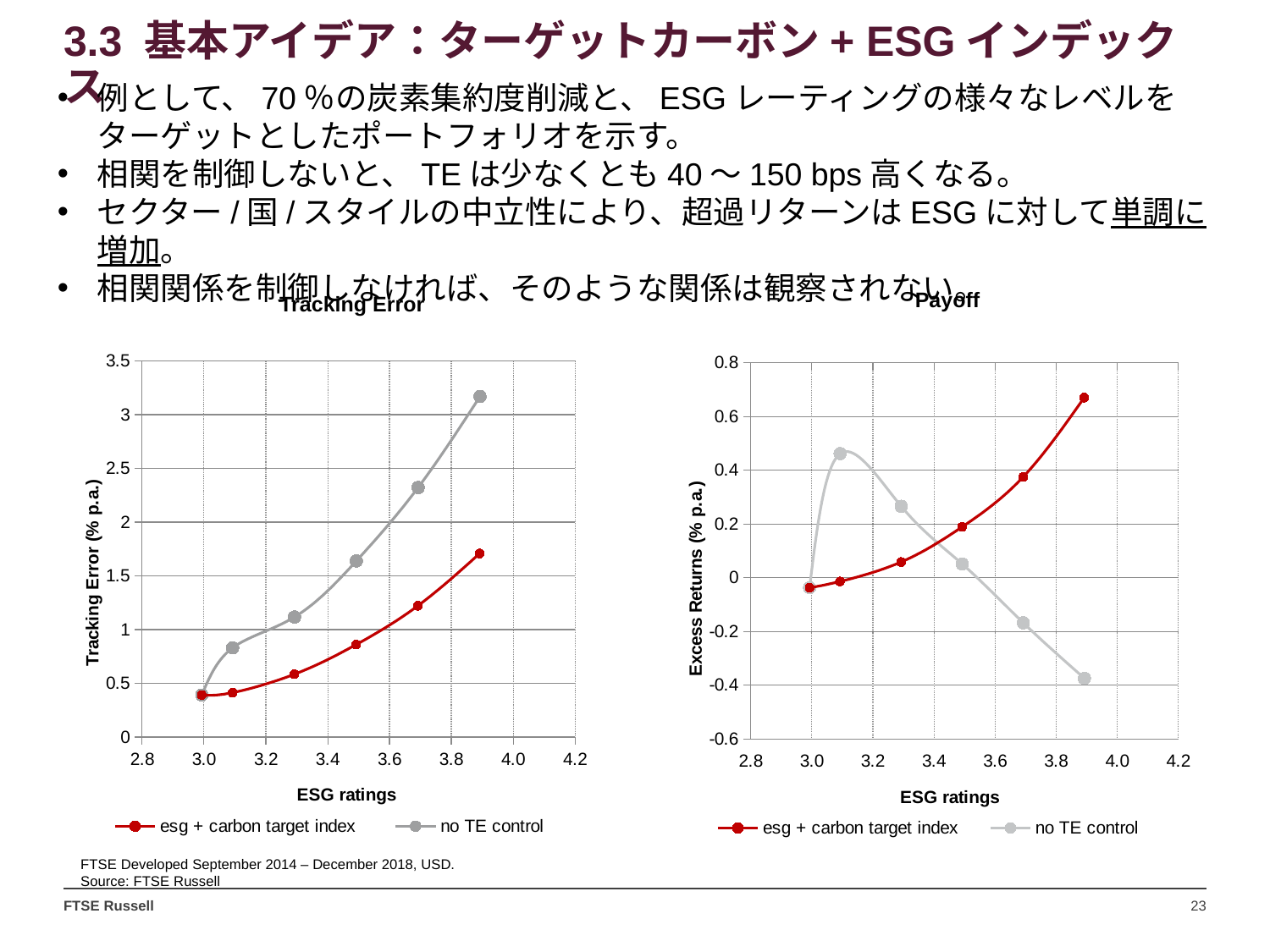
In the Tracking Error chart, does the tracking error of the 'esg + carbon target index' series rise or fall as ESG ratings increase? rise How many series does the legend of the Payoff chart list? 2 In the Tracking Error chart, is the value for 'esg + carbon target index' at an ESG rating of 3.9 greater or less than 1.5? greater In the Payoff chart, is the value for 'no TE control' at an ESG rating of 3.9 greater or less than -0.2? less What kind of chart is the Tracking Error chart? line chart In the Tracking Error chart, is the value for 'no TE control' at an ESG rating of 3.9 greater or less than 3? greater What is the label of the y axis of the Payoff chart? Excess Returns (% p.a.) In the Payoff chart, which series reaches the highest excess return? esg + carbon target index In the Payoff chart, do the excess returns of the 'esg + carbon target index' series rise or fall as ESG ratings increase? rise How many data points are plotted for the 'esg + carbon target index' series in the Tracking Error chart? 6 In the Tracking Error chart, which series has the higher value at an ESG rating of 3.7? no TE control